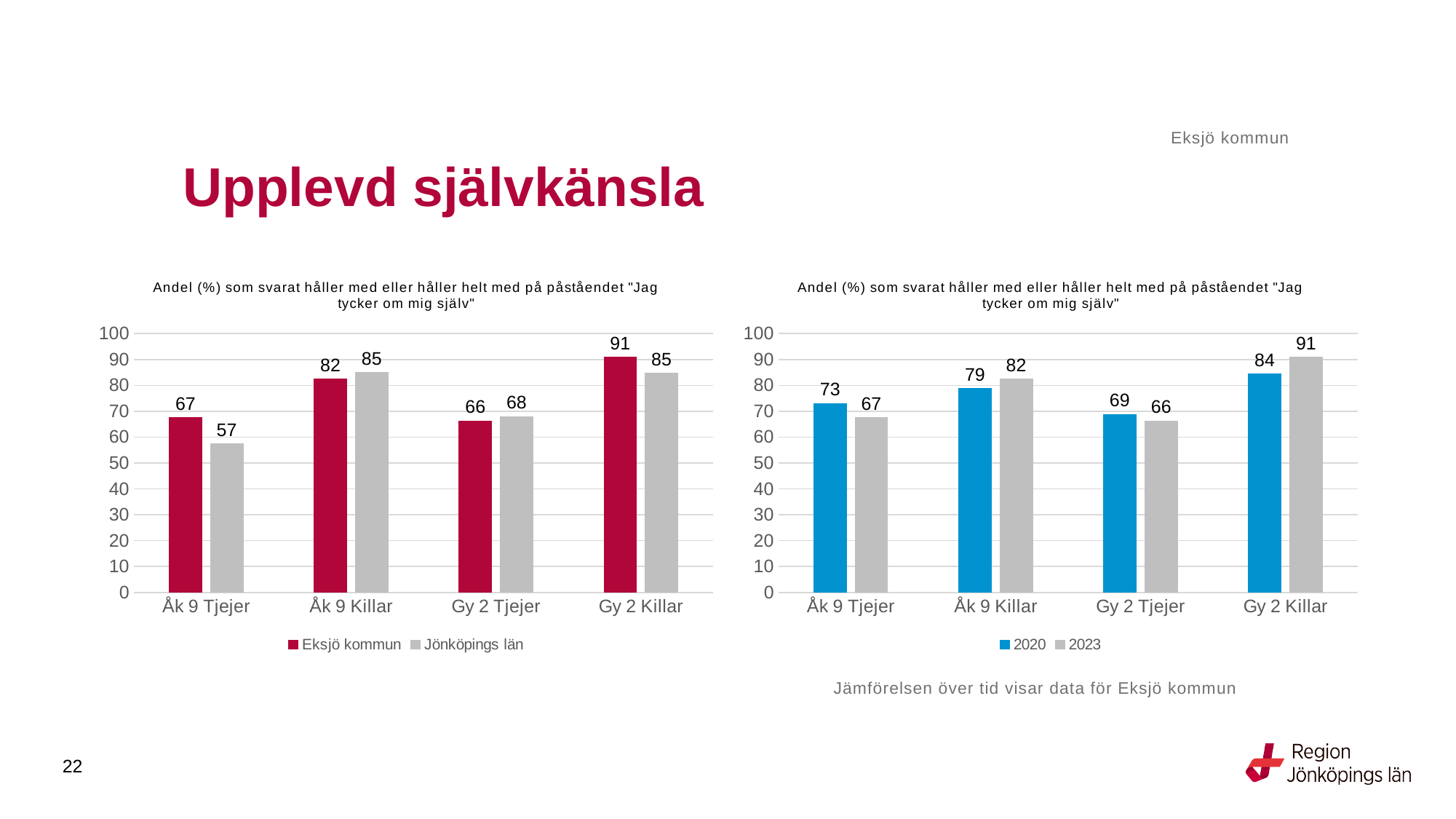
How many categories are shown on the x axis of the right chart? 4 In the right chart, what is the difference between 2023 and 2020 for Gy 2 Killar? 7 How many series does the legend of the left chart list? 2 In the left chart, which category has the lowest value for Jönköpings län? Åk 9 Tjejer In the left chart, which category has the highest value for Eksjö kommun? Gy 2 Killar In the left chart, what is the value for Eksjö kommun for Åk 9 Tjejer? 67 In the right chart, what is the value for 2020 for Gy 2 Tjejer? 69 In the right chart, which is larger for Åk 9 Tjejer, the 2020 value or the 2023 value? 2020 In the right chart, what is the value for 2023 for Gy 2 Killar? 91 What kind of chart is the right chart? Bar chart In the left chart, what is the value for Jönköpings län for Gy 2 Killar? 85 In the left chart, what is the difference between Eksjö kommun and Jönköpings län for Åk 9 Tjejer? 10